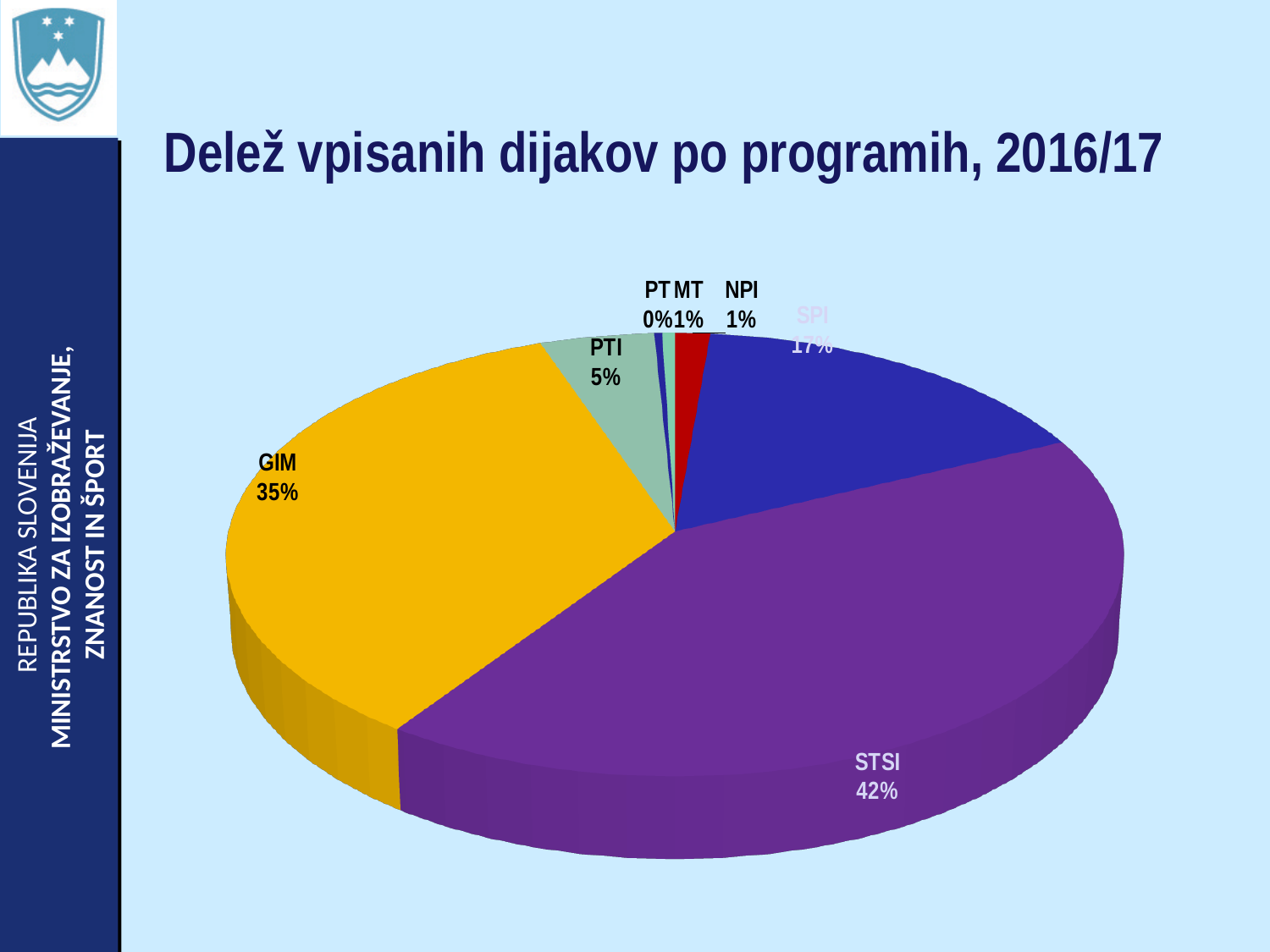
What is the title of the chart? Delež vpisanih dijakov po programih, 2016/17 What share of the pie does PTI have? 5% What is the difference between the shares of STSI and GIM? 7% How many slices does the pie chart have? 7 Which program has the largest share of the pie? STSI What kind of chart is shown on the slide? pie chart What share of the pie does NPI have? 1% What share of the pie does STSI have? 42% What share of the pie does GIM have? 35% Which program has the smallest share of the pie? PT What share of the pie does SPI have? 17% Which has a larger share, SPI or PTI? SPI